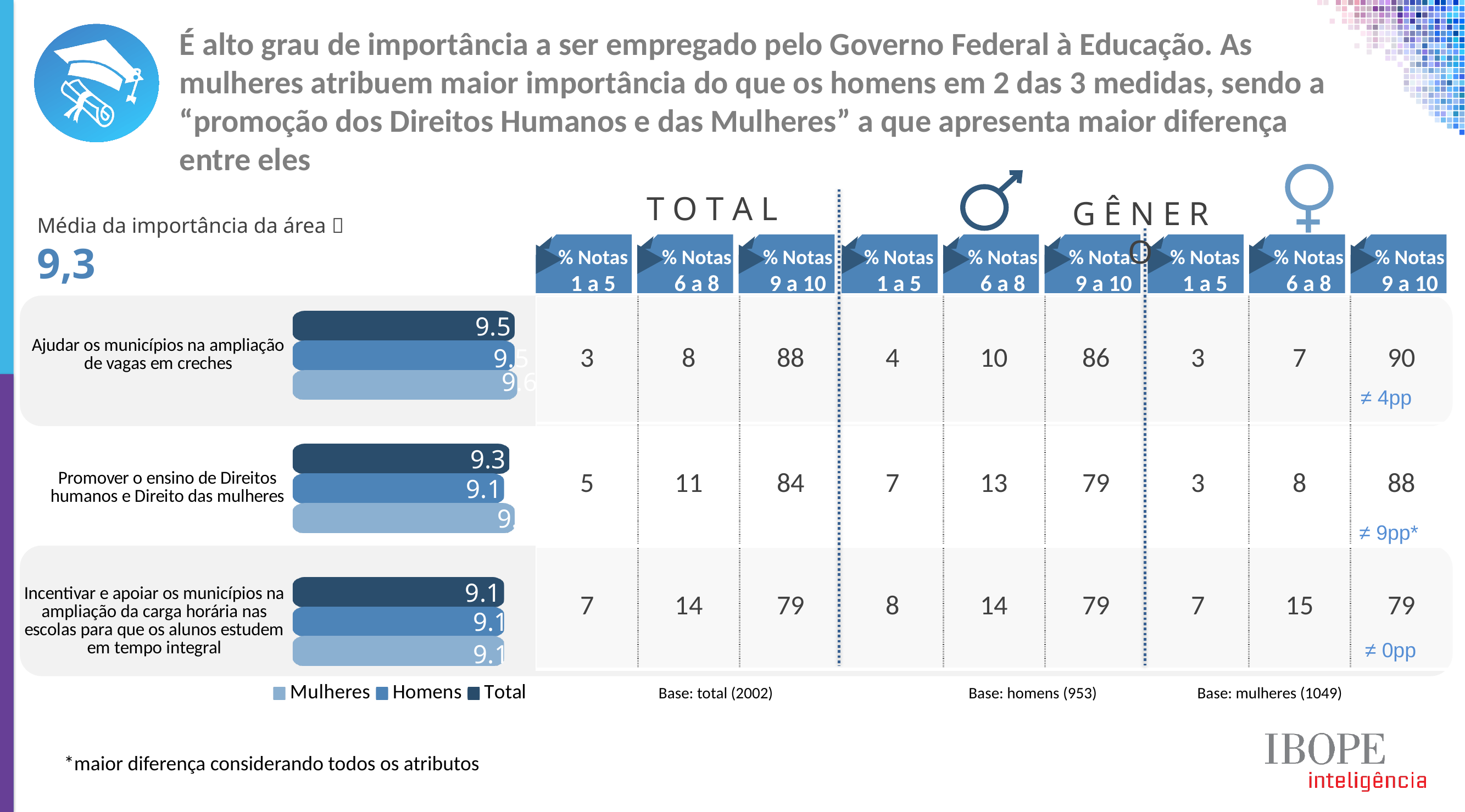
What is the Total value for "Incentivar e apoiar os municípios na ampliação da carga horária nas escolas para que os alunos estudem em tempo integral" in the bar chart? 9.1 How many categories (measures) are shown in the bar chart? 3 What is the Total value for "Promover o ensino de Direitos humanos e Direito das mulheres" in the bar chart? 9.3 What kind of chart is used to show the average importance scores on the slide? bar chart What is the difference between the Total value for "Ajudar os municípios na ampliação de vagas em creches" and the Total value for "Incentivar e apoiar os municípios na ampliação da carga horária..."? 0.4 What are the three legend entries of the bar chart? Mulheres, Homens, Total Which category has the highest Total value in the bar chart? Ajudar os municípios na ampliação de vagas em creches Which has the larger Total value: "Ajudar os municípios na ampliação de vagas em creches" or "Promover o ensino de Direitos humanos e Direito das mulheres"? Ajudar os municípios na ampliação de vagas em creches What is the Homens value for "Promover o ensino de Direitos humanos e Direito das mulheres" in the bar chart? 9.1 What is the Mulheres value for "Ajudar os municípios na ampliação de vagas em creches" in the bar chart? 9.6 What is the Total value for "Ajudar os municípios na ampliação de vagas em creches" in the bar chart? 9.5 How many series does the legend of the bar chart list? 3